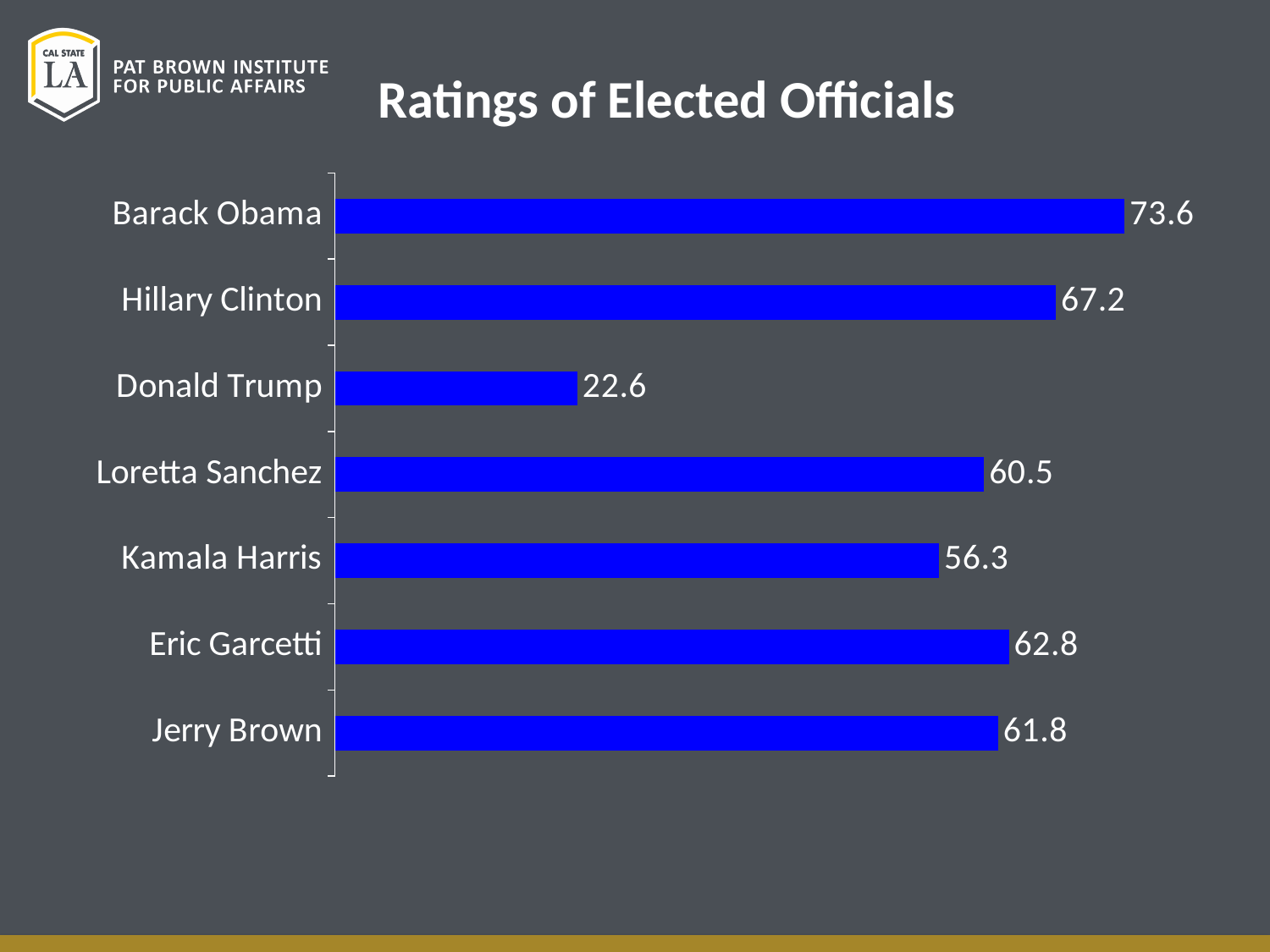
What is the difference between Barack Obama's rating and Hillary Clinton's rating? 6.4 What is the difference between Eric Garcetti's rating and Jerry Brown's rating? 1.0 What kind of chart is shown on the slide? Bar chart What is the rating for Jerry Brown? 61.8 What is the rating for Kamala Harris? 56.3 How many elected officials are shown in the chart? 7 What is the rating for Barack Obama? 73.6 Which elected official has the highest rating? Barack Obama Who has a higher rating, Loretta Sanchez or Kamala Harris? Loretta Sanchez Which elected official has the lowest rating? Donald Trump What is the title of the chart? Ratings of Elected Officials What is the rating for Donald Trump? 22.6